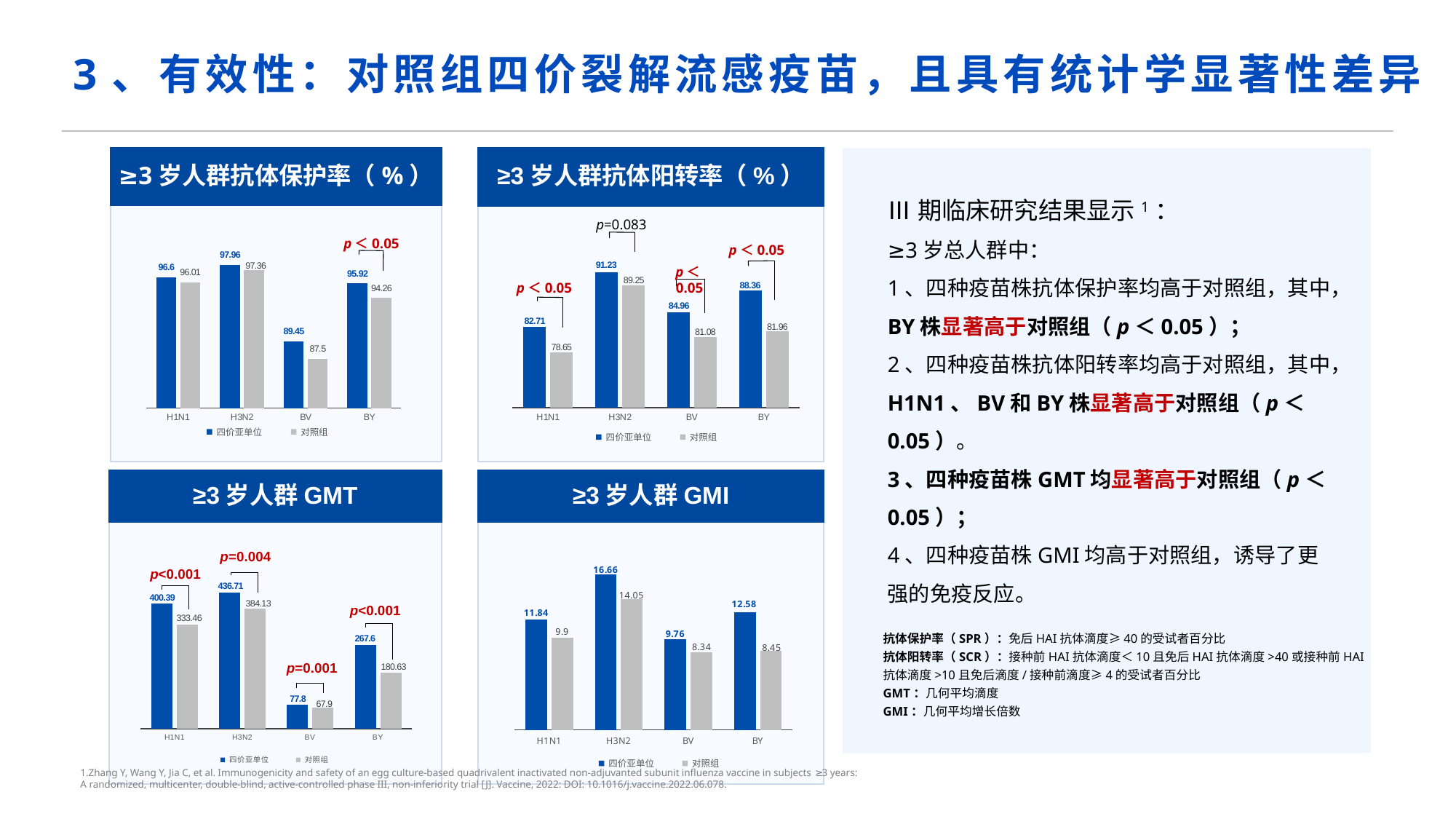
In the "≥3岁人群抗体保护率（%）" chart, what is the value for 对照组 for H3N2? 97.36 In the "≥3岁人群GMT" chart, what is the value for 四价亚单位 for H3N2? 436.71 In the "≥3岁人群GMI" chart, what is the value for 对照组 for BY? 8.45 How many strain categories are shown on the x axis of the "≥3岁人群GMI" chart? 4 In the "≥3岁人群抗体阳转率（%）" chart, which strain has the highest 四价亚单位 value? H3N2 In the "≥3岁人群GMT" chart, which strain has the lowest 对照组 value? BV In the "≥3岁人群抗体阳转率（%）" chart, what is the difference between the 四价亚单位 and 对照组 values for BY? 6.4 In the "≥3岁人群GMT" chart, what is the difference between the 四价亚单位 and 对照组 values for BY? 86.97 In the "≥3岁人群抗体阳转率（%）" chart, what is the value for 对照组 for H1N1? 78.65 In the "≥3岁人群GMI" chart, which is larger for H1N1: 四价亚单位 or 对照组? 四价亚单位 How many series does the legend of the "≥3岁人群GMT" chart list? 2 In the "≥3岁人群抗体保护率（%）" chart, what is the value for 四价亚单位 for BV? 89.45